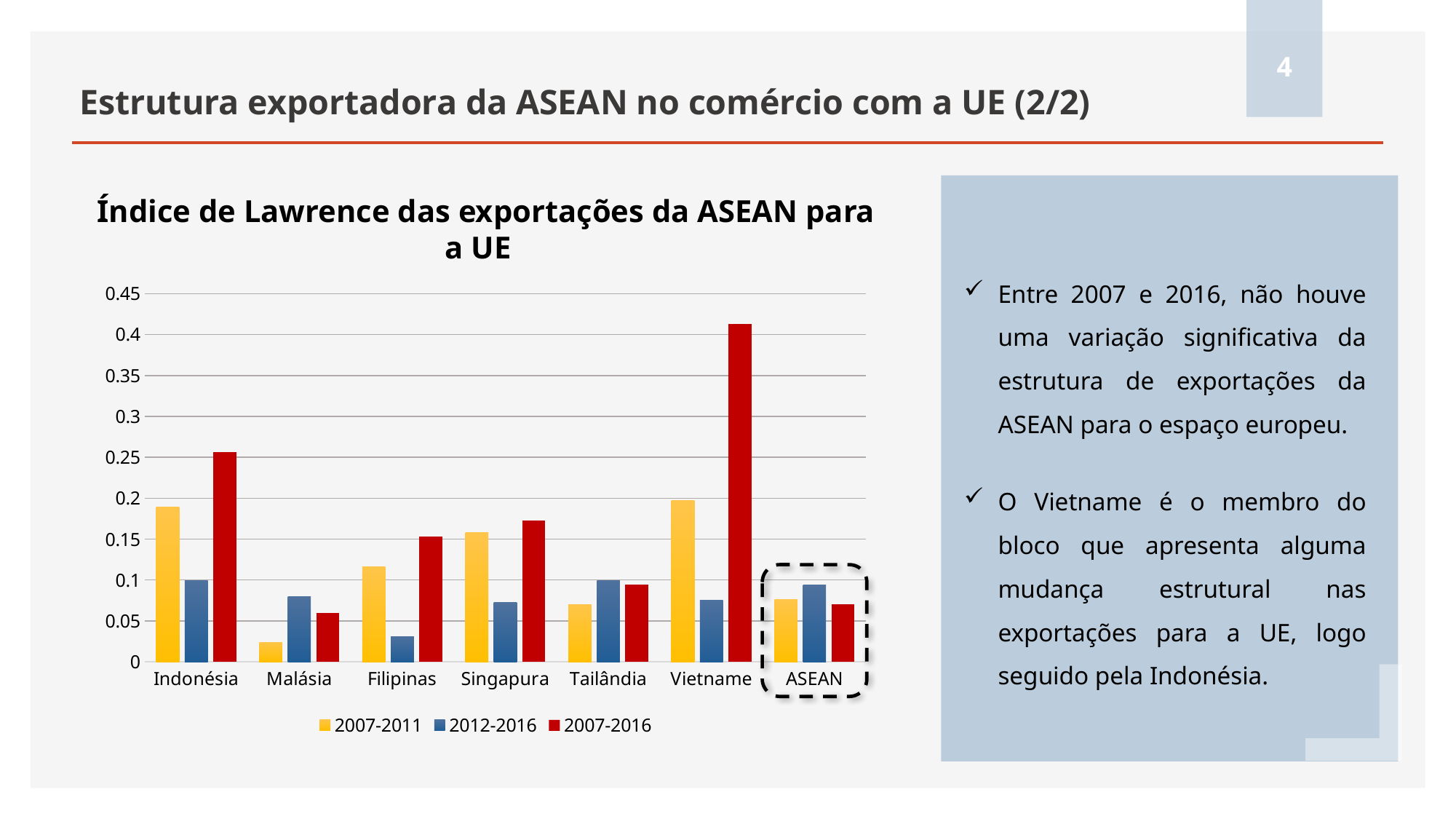
How many series does the legend of the chart list? 3 What kind of chart is shown on the slide? bar chart Is the 2007-2016 value for Vietname greater or less than 0.35? greater Which category has the lowest value for the 2007-2011 series? Malásia For the 2007-2011 series, which is larger: Indonésia or Malásia? Indonésia Is the 2007-2016 value for Indonésia greater or less than 0.2? greater How many categories are shown on the x axis of the chart? 7 What is the title of the chart? Índice de Lawrence das exportações da ASEAN para a UE Which category has the highest value for the 2007-2016 series? Vietname For Filipinas, which series has the larger value: 2012-2016 or 2007-2016? 2007-2016 Which category has the lowest value for the 2012-2016 series? Filipinas Is the 2007-2011 value for Malásia greater or less than 0.05? less